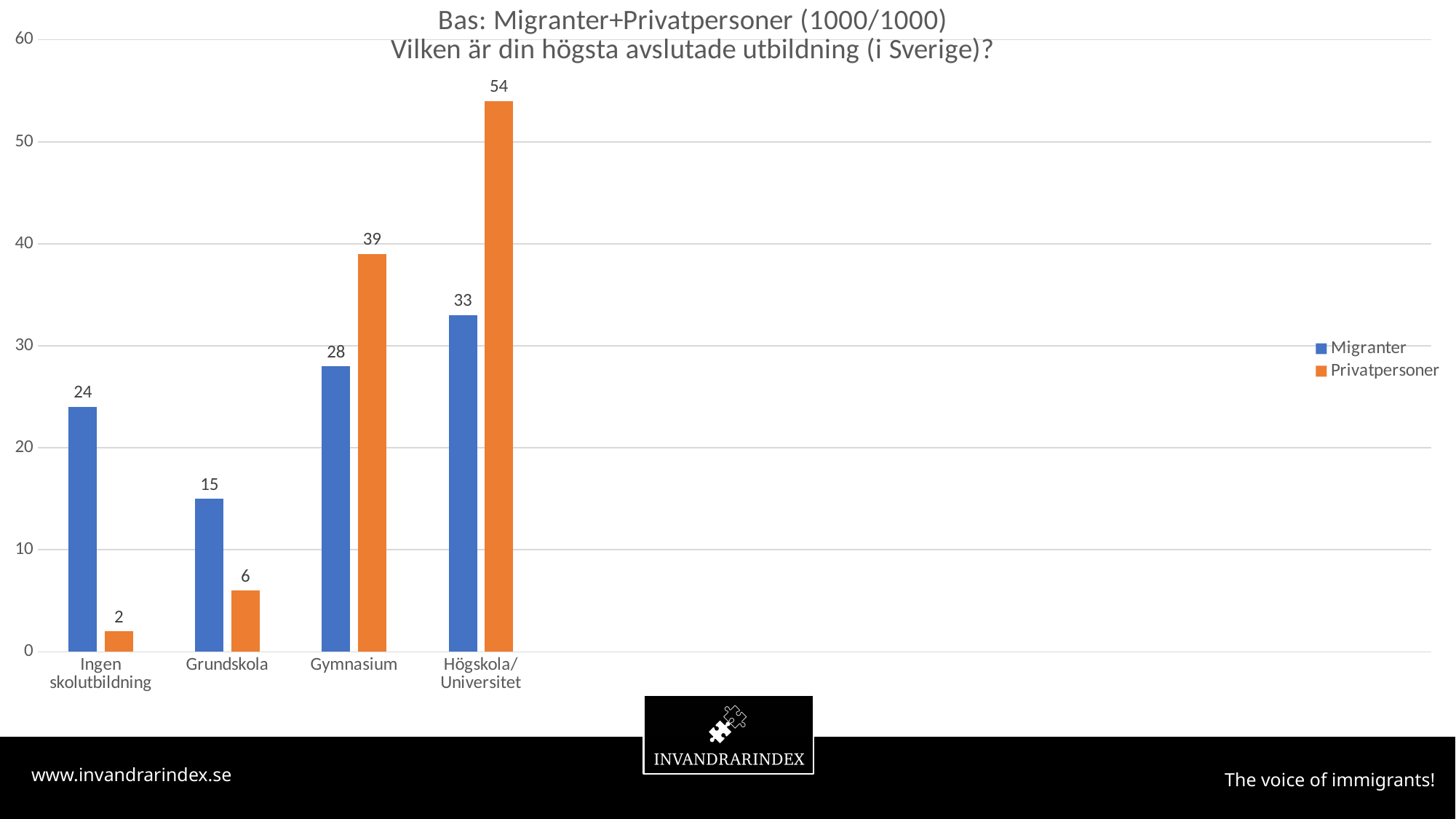
Which category has the lowest value for Migranter? Grundskola What is the value for Privatpersoner in the Högskola/Universitet category? 54 Which category has the highest value for Privatpersoner? Högskola/Universitet What kind of chart is shown on the slide? Bar chart How many series does the legend list? 2 What is the difference between Privatpersoner and Migranter in the Högskola/Universitet category? 21 Which colour represents the Privatpersoner series? Orange How many categories are shown on the x axis? 4 Is the value for Privatpersoner in the Gymnasium category greater or less than 30? greater Which is larger in the Ingen skolutbildning category, Migranter or Privatpersoner? Migranter What is the value for Privatpersoner in the Ingen skolutbildning category? 2 What is the value for Migranter in the Gymnasium category? 28